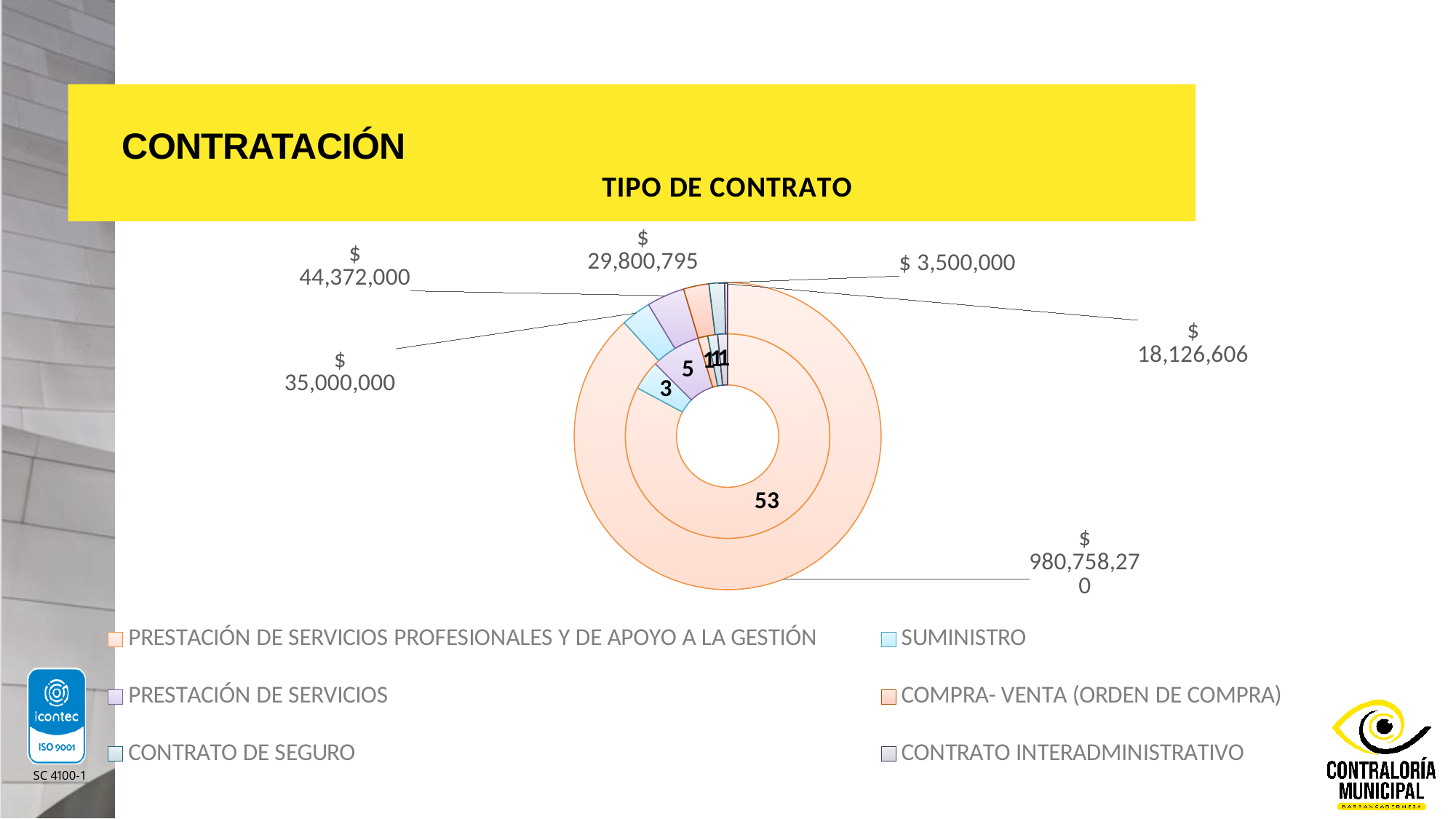
How many contract types does the legend list? 6 Which has the larger inner-ring count, SUMINISTRO or PRESTACIÓN DE SERVICIOS? PRESTACIÓN DE SERVICIOS What is the value shown for PRESTACIÓN DE SERVICIOS PROFESIONALES Y DE APOYO A LA GESTIÓN on the outer ring? $ 980,758,270 What is the difference between the inner-ring counts for PRESTACIÓN DE SERVICIOS PROFESIONALES Y DE APOYO A LA GESTIÓN and PRESTACIÓN DE SERVICIOS? 48 What is the title of the chart? TIPO DE CONTRATO What is the largest value shown on the outer ring of the chart? $ 980,758,270 What is the smallest value shown on the outer ring of the chart? $ 3,500,000 Which category has the largest count on the inner ring? PRESTACIÓN DE SERVICIOS PROFESIONALES Y DE APOYO A LA GESTIÓN What count is shown for PRESTACIÓN DE SERVICIOS PROFESIONALES Y DE APOYO A LA GESTIÓN on the inner ring? 53 What count is shown for PRESTACIÓN DE SERVICIOS on the inner ring? 5 What count is shown for SUMINISTRO on the inner ring? 3 What kind of chart is shown on the slide? Doughnut (pie) chart